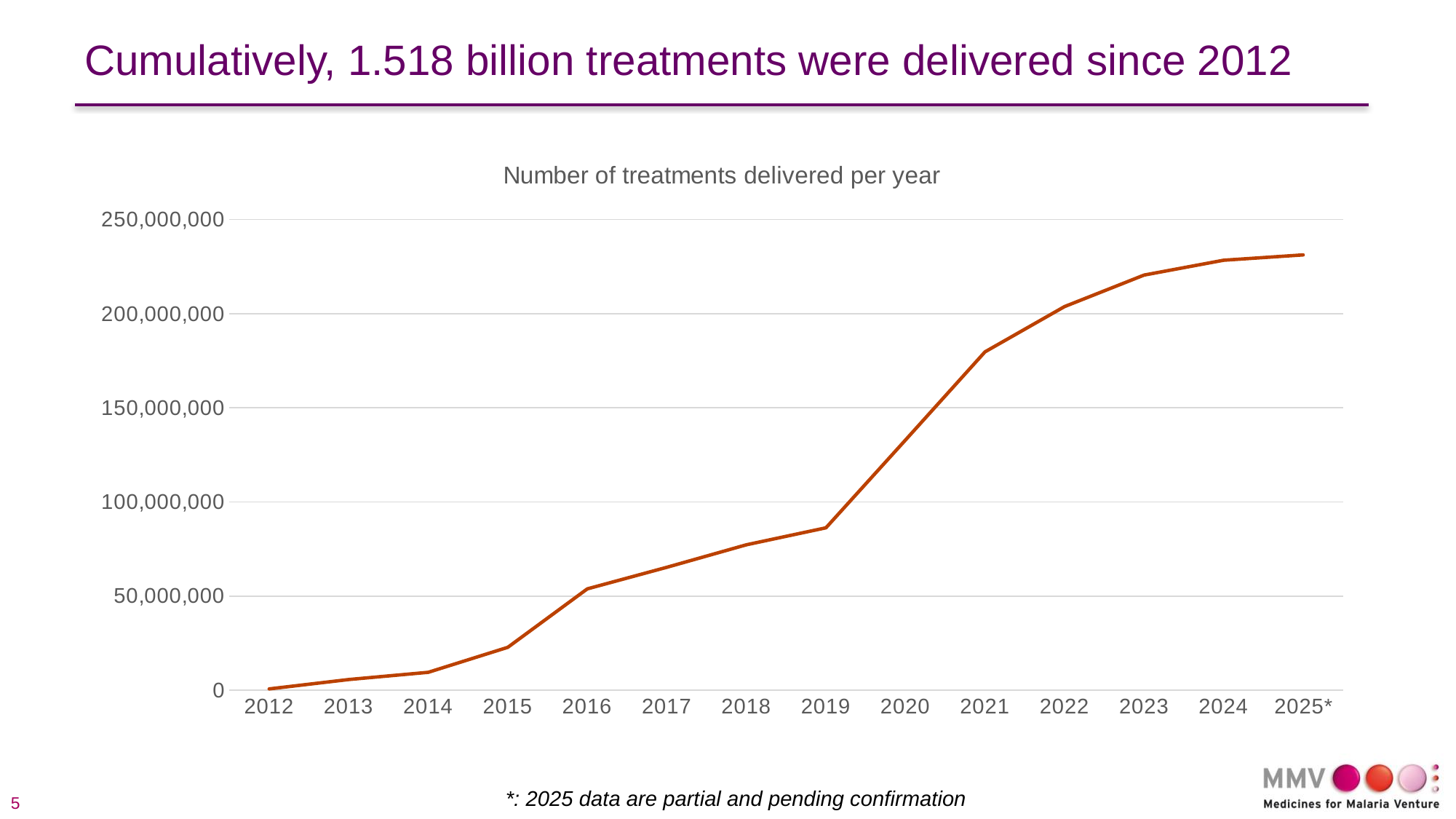
Do the values rise or fall from 2012 to 2025*? Rise What is the title of the chart? Number of treatments delivered per year Which year has the larger value, 2015 or 2018? 2018 Is the value for 2023 greater or less than 200,000,000? greater Is the value for 2019 greater or less than 100,000,000? less Is the value for 2016 greater or less than 50,000,000? greater Which year has the highest number of treatments delivered? 2025* Which year has the lowest number of treatments delivered? 2012 Which year has the larger value, 2020 or 2022? 2022 What kind of chart is shown on the slide? Line chart How many years are plotted on the x axis of the chart? 14